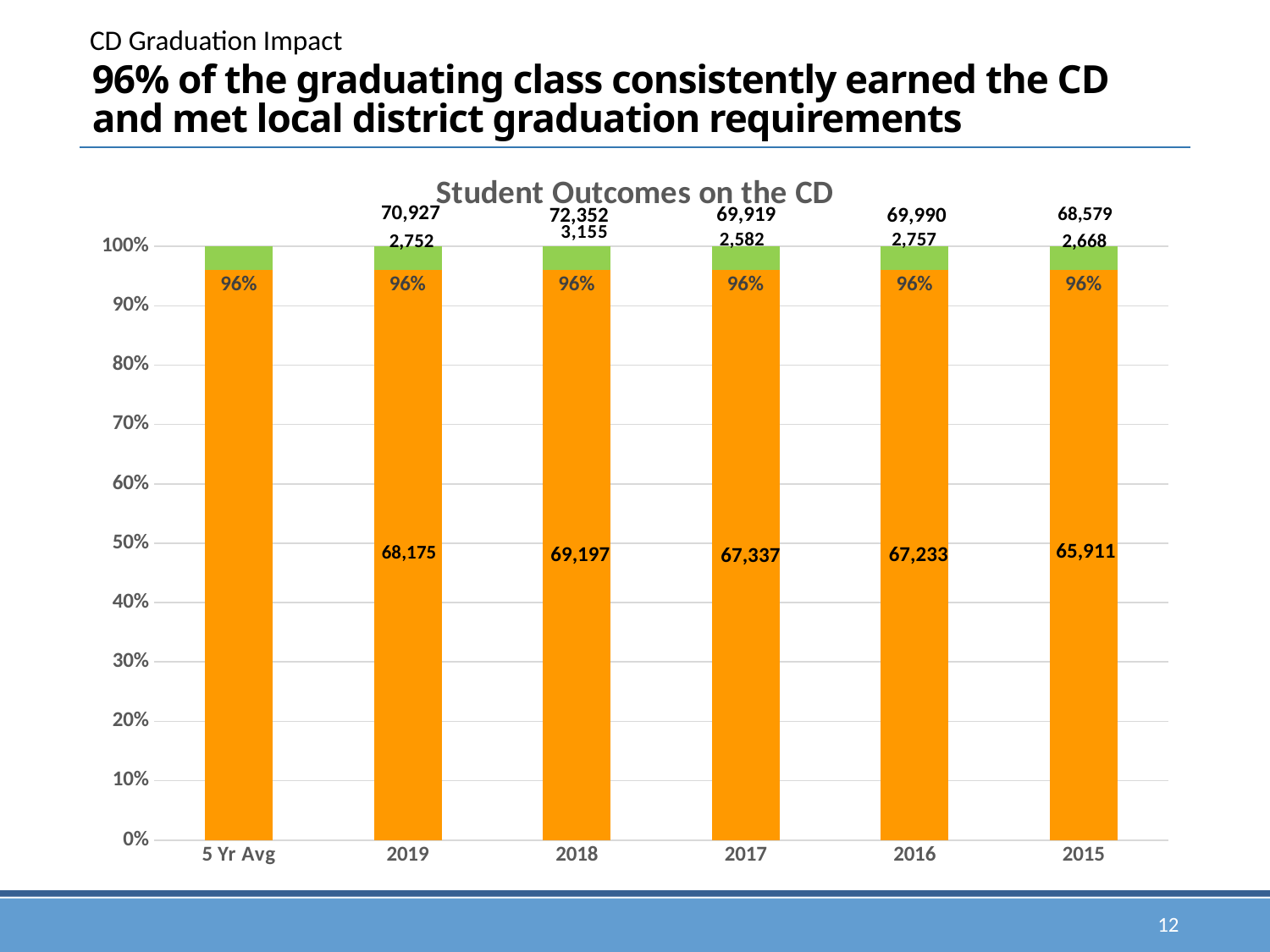
What percentage label appears on the orange segment of the 2015 bar? 96% How many bars are shown in the chart? 6 What is the title of the chart? Student Outcomes on the CD What is the difference between the totals printed above the 2018 and 2015 bars? 3,773 Which year has the highest orange-segment value? 2018 What is the green-segment value shown for 2018? 3,155 What is the difference between the orange-segment values for 2018 and 2019? 1,022 What is the orange-segment value for 2019 in the Student Outcomes on the CD chart? 68,175 What total is printed above the bar for 2017? 69,919 Which is larger, the green-segment value for 2016 or for 2019? 2016 Which year has the lowest orange-segment value? 2015 Which year has the lowest green-segment value? 2017